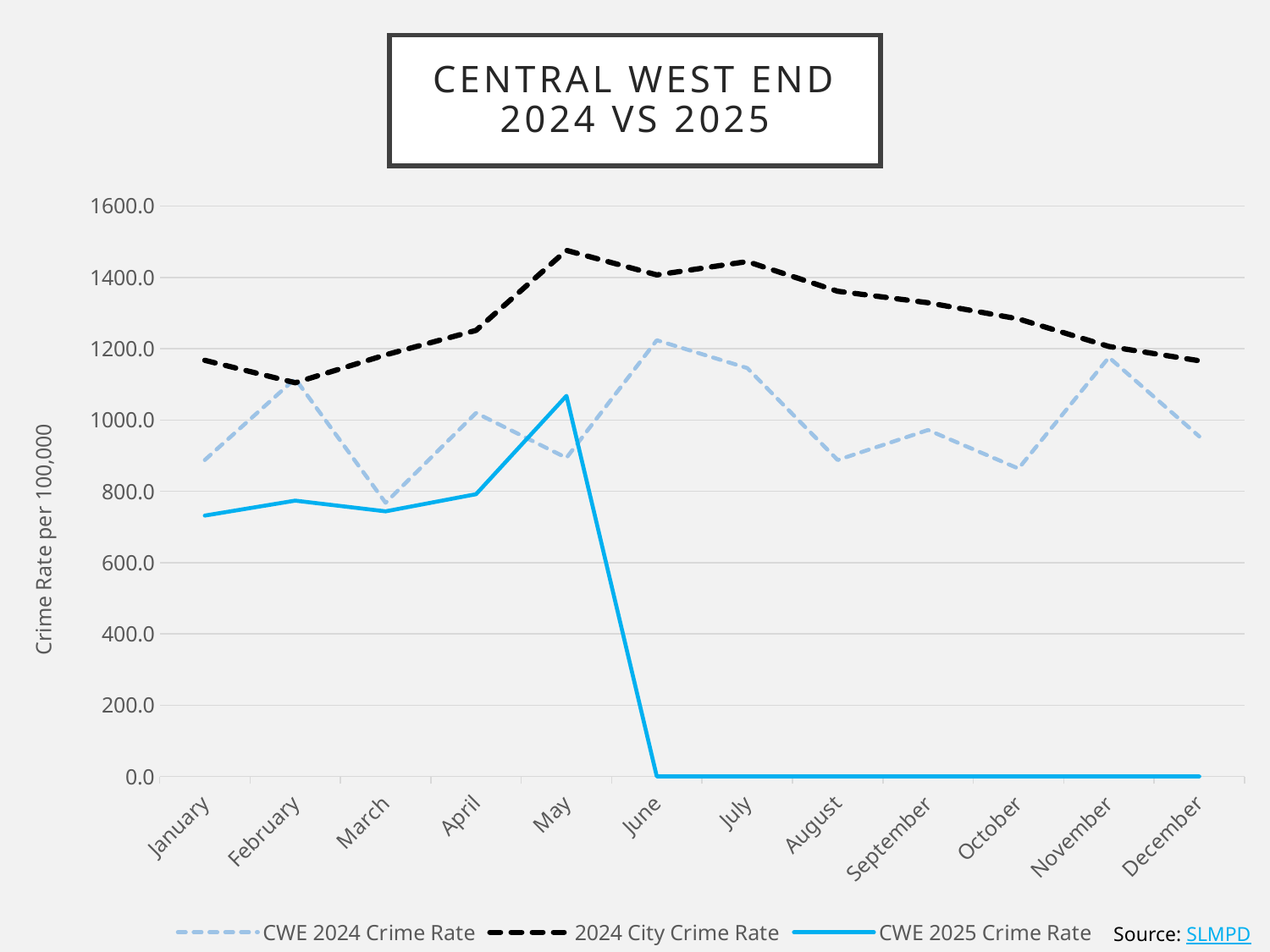
In which month is the 2024 City Crime Rate at its lowest? February How many series does the legend list? 3 How many months are plotted along the x axis? 12 What kind of chart is shown on the slide? line chart In which month does the CWE 2025 Crime Rate reach its highest value? May Is the CWE 2025 Crime Rate in January greater or less than 800? less What is the CWE 2025 Crime Rate value plotted for June? 0.0 Is the 2024 City Crime Rate in May greater or less than 1400? greater Is the CWE 2024 Crime Rate in June greater or less than 1000? greater In January, which is higher: the 2024 City Crime Rate or the CWE 2024 Crime Rate? 2024 City Crime Rate In May, which is higher: the CWE 2025 Crime Rate or the CWE 2024 Crime Rate? CWE 2025 Crime Rate Does the 2024 City Crime Rate rise or fall from May to December? fall